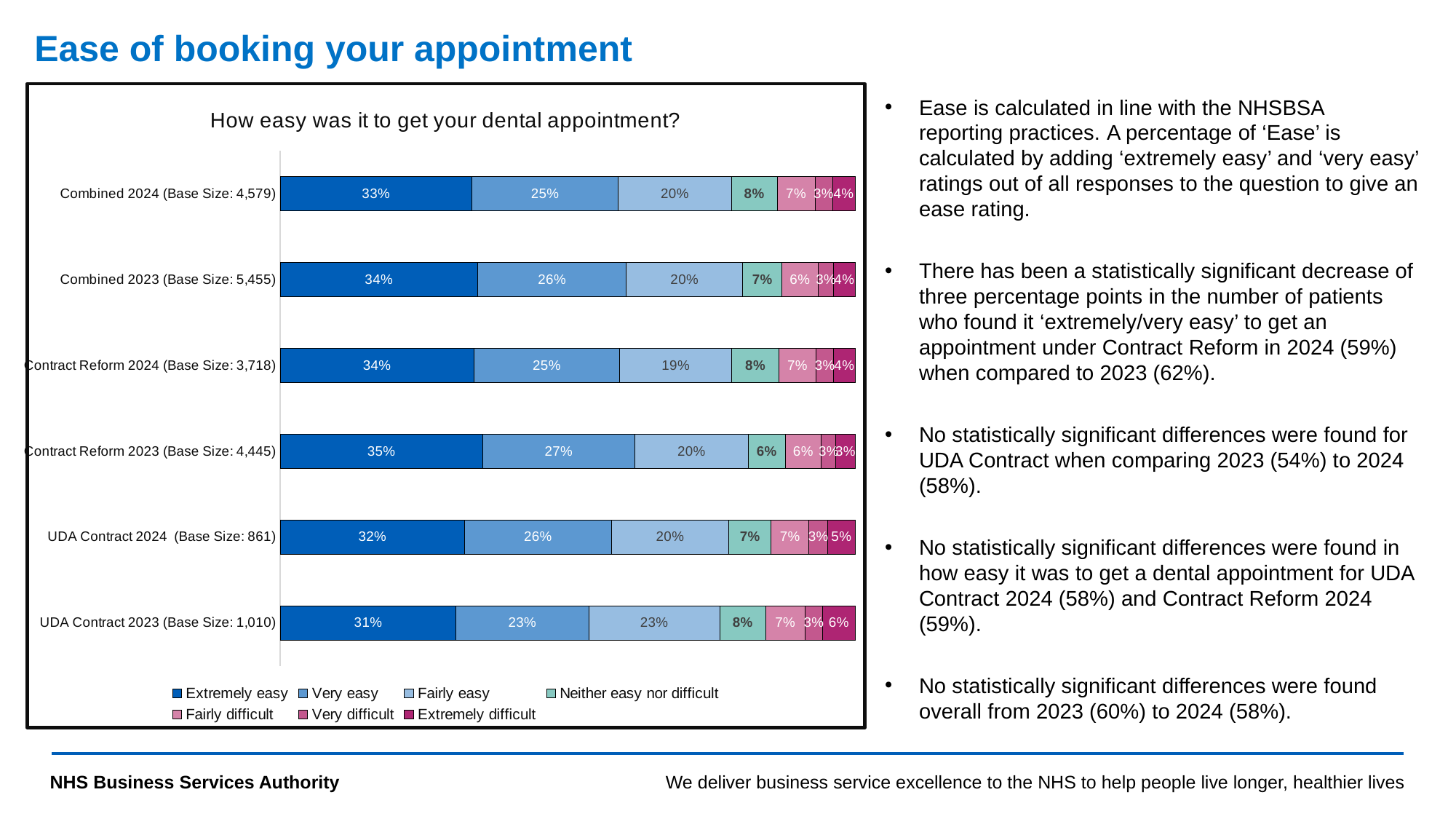
What is the 'Very easy' value for Contract Reform 2023? 27% What percentage of Combined 2024 respondents said it was 'Extremely easy' to get their dental appointment? 33% Which category has the highest 'Extremely easy' percentage? Contract Reform 2023 (Base Size: 4,445) Which category has the lowest 'Extremely easy' percentage? UDA Contract 2023 (Base Size: 1,010) What is the difference between the 'Very easy' values for Contract Reform 2023 and UDA Contract 2023? 4 percentage points What is the 'Fairly easy' value for UDA Contract 2023? 23% What is the title of the chart? How easy was it to get your dental appointment? What kind of chart is shown on the slide? Stacked bar chart How many categories (bars) are shown in the chart? 6 What is the 'Extremely difficult' value for UDA Contract 2024? 5% Which is larger: the 'Neither easy nor difficult' value for Combined 2024 or for Combined 2023? Combined 2024 How many series does the legend list? 7